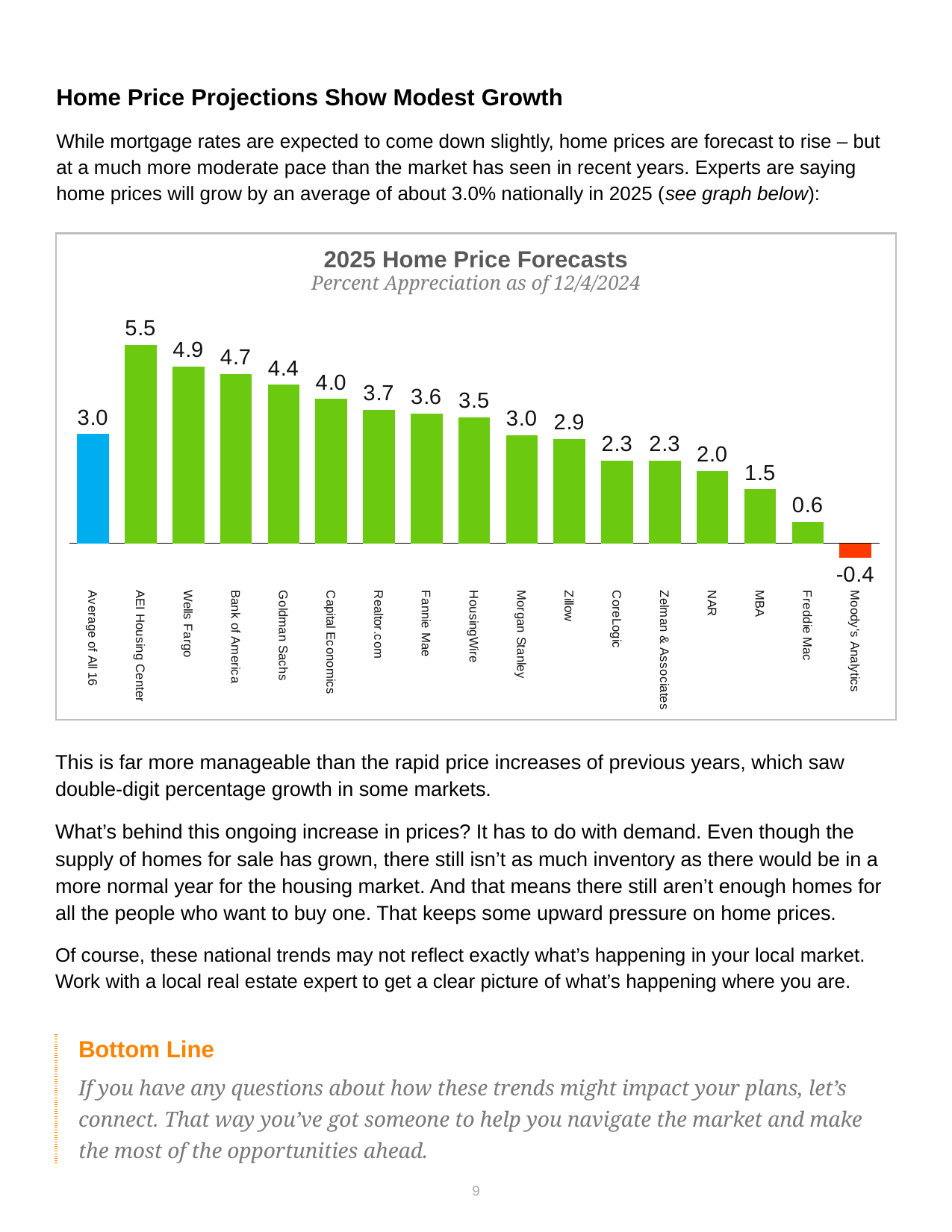
Which forecaster has the highest 2025 home price forecast? AEI Housing Center What is the difference between the forecasts of AEI Housing Center and Freddie Mac? 4.9 What is the forecast value for Moody's Analytics? -0.4 How many bars are shown in the chart? 17 What is the value shown for Average of All 16? 3.0 What is the 2025 home price forecast for Wells Fargo? 4.9 What is the subtitle of the chart? Percent Appreciation as of 12/4/2024 What is the title of the chart? 2025 Home Price Forecasts Which forecaster has the lowest 2025 home price forecast? Moody's Analytics Do the forecast values rise or fall moving from AEI Housing Center to Moody's Analytics along the x axis? Fall What kind of chart is shown on the slide? Bar chart Which has a higher forecast, Goldman Sachs or Zillow? Goldman Sachs